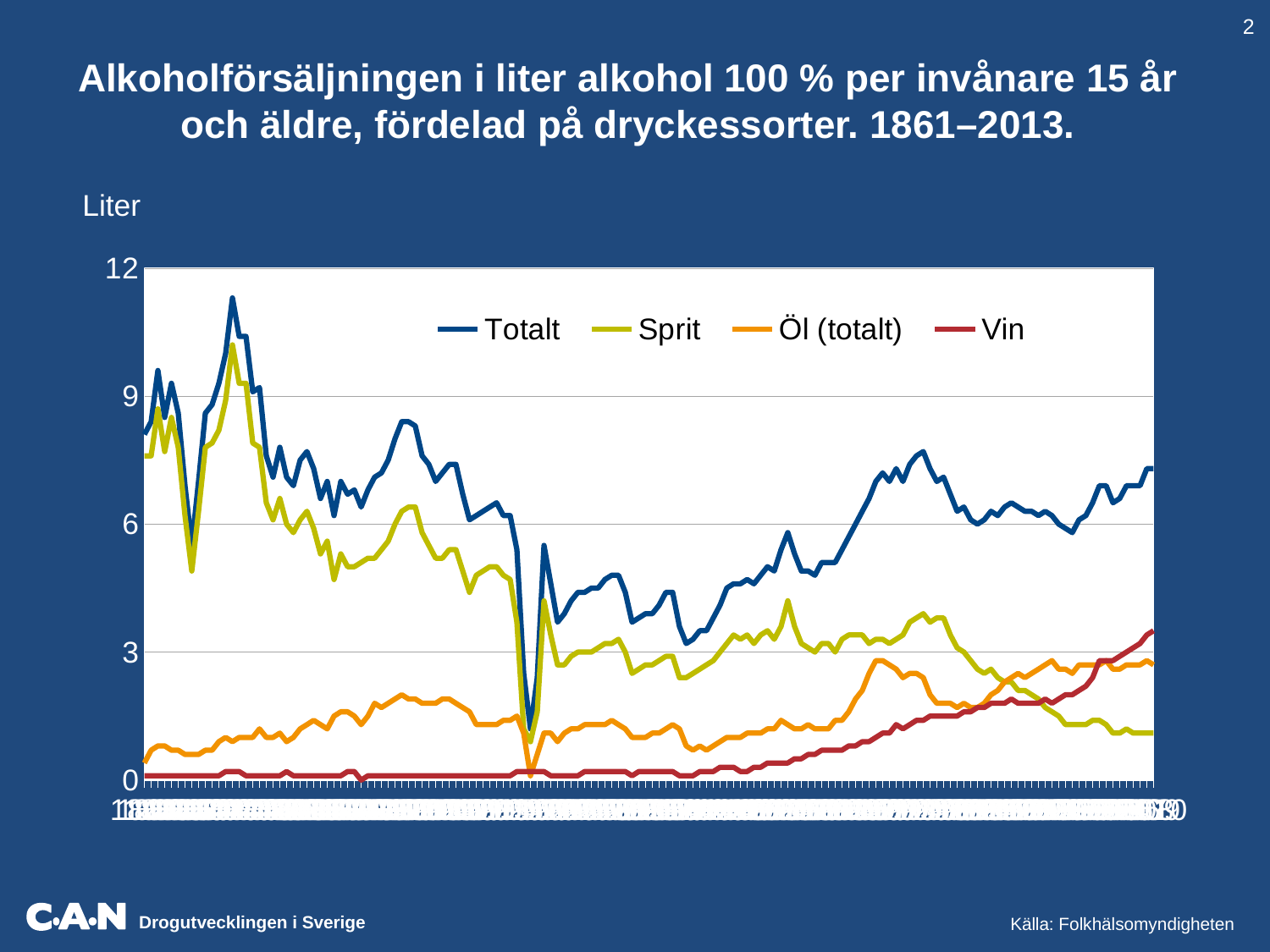
At the right end of the chart, is the Sprit value greater or less than 3? less Is the peak value of the Totalt series greater or less than 9? greater What kind of chart is shown on the slide? Line chart What unit is shown on the y-axis label above the chart? Liter Which series are listed in the legend? Totalt, Sprit, Öl (totalt), Vin At the left end of the chart, which is larger, Sprit or Öl (totalt)? Sprit At the right end of the chart, which is larger, Vin or Sprit? Vin Does the Sprit series rise or fall from the left end to the right end of the chart? Fall How many series does the legend list? 4 Which series has the highest values across the whole chart? Totalt Which series has the lowest values at the left end of the chart? Vin Does the Vin series rise or fall from the left end to the right end of the chart? Rise